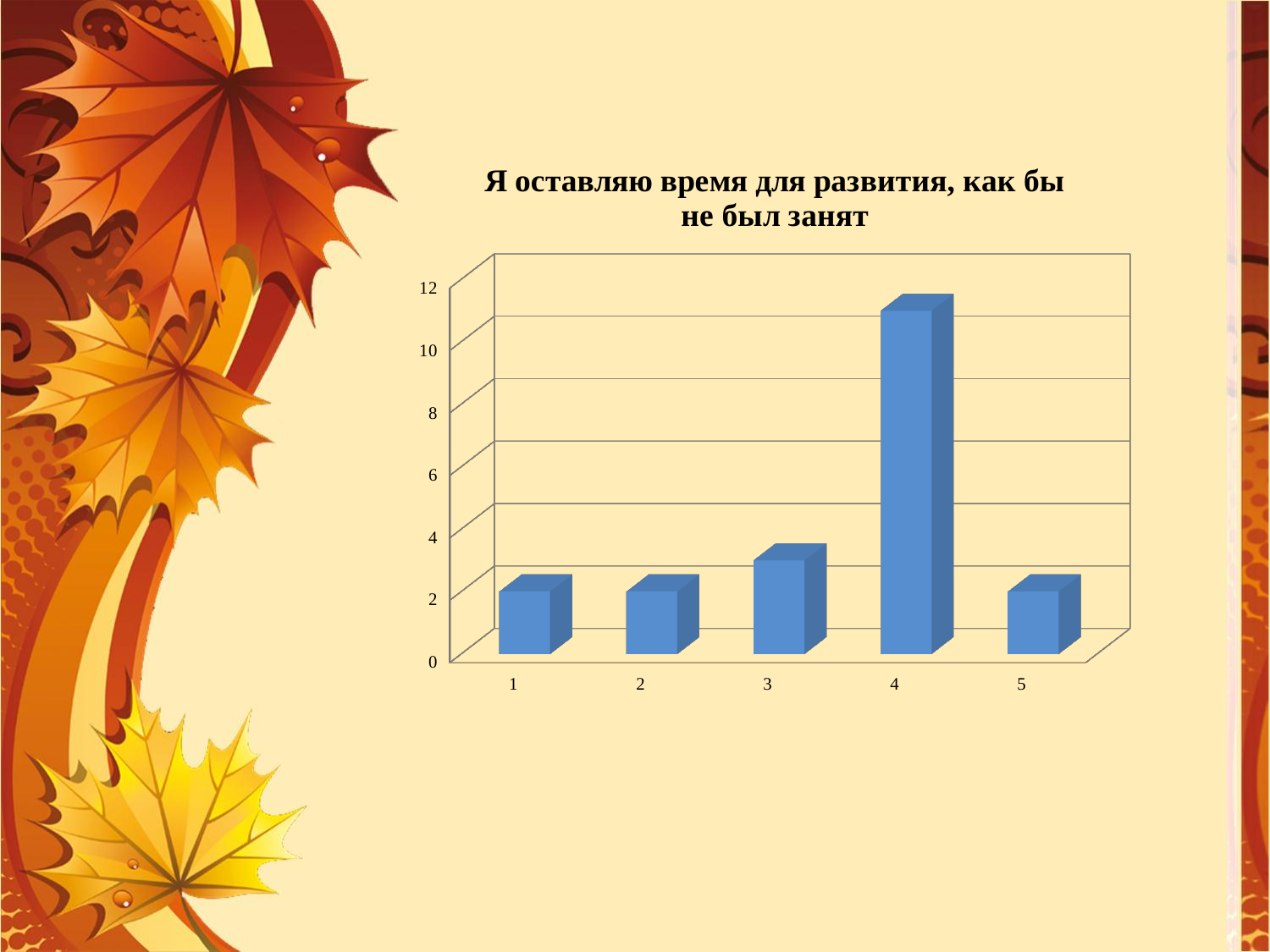
Is the value for category 1 greater or less than 4? less Is the value for category 3 greater or less than 4? less How many categories are plotted on the x axis of the chart? 5 Is the value for category 4 greater or less than 8? greater Which has the larger value, category 4 or category 3? 4 What is the title of the chart? Я оставляю время для развития, как бы не был занят Which category has the highest bar in the chart? 4 Which has the larger value, category 3 or category 1? 3 What is the highest value shown on the vertical axis of the chart? 12 What kind of chart is shown on the slide? bar chart